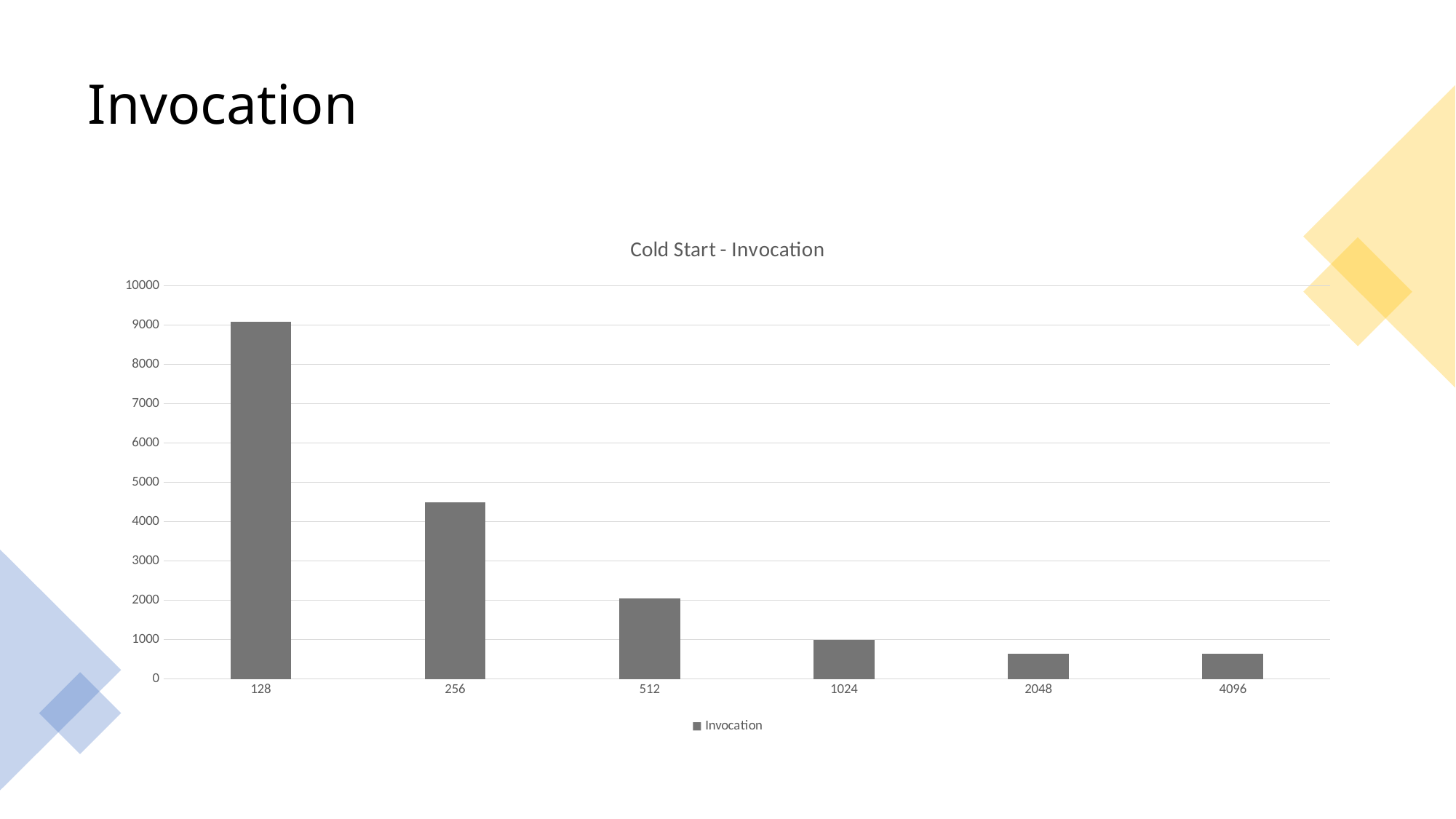
What is the title of the chart? Cold Start - Invocation Which is larger, the value for 256 or the value for 512? 256 How many categories are shown on the x axis? 6 What is the name of the series shown in the legend? Invocation Do the values rise or fall as you move from 128 to 4096 along the x axis? fall Which category has the highest value? 128 How many series does the legend list? 1 What kind of chart is shown on the slide? bar chart Is the value for 256 greater or less than 5000? less